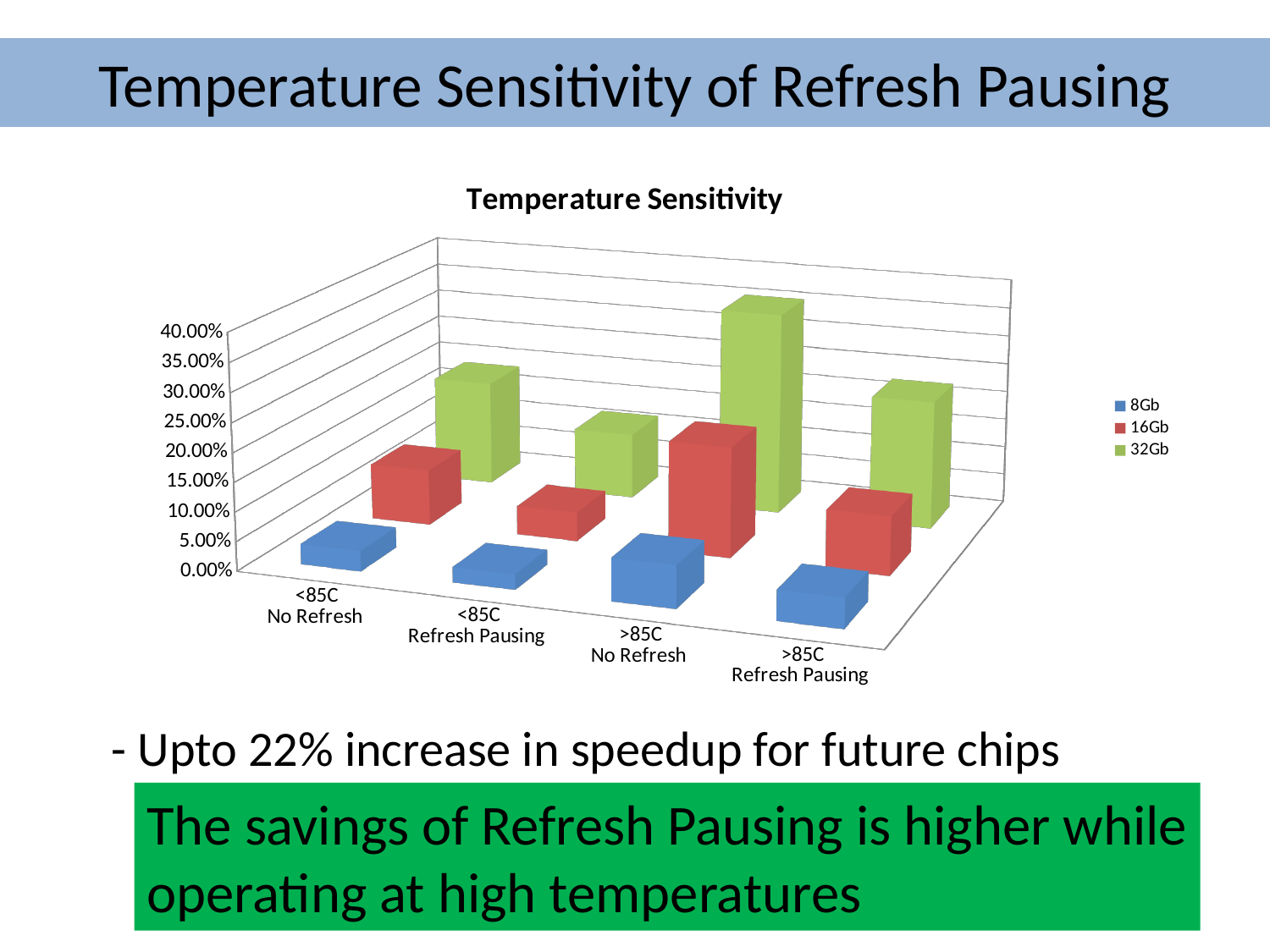
What is the title of the chart? Temperature Sensitivity For the "<85C No Refresh" category, which is larger: the 32Gb value or the 8Gb value? 32Gb Which series are listed in the legend? 8Gb, 16Gb, 32Gb For the 16Gb series, which is larger: the value for ">85C No Refresh" or the value for "<85C Refresh Pausing"? >85C No Refresh How many series does the legend list? 3 How many categories are shown on the x axis? 4 Which series has the lowest value for the ">85C Refresh Pausing" category? 8Gb Is the 32Gb value for ">85C No Refresh" greater or less than 20.00%? greater Is the 8Gb value for "<85C No Refresh" greater or less than 10.00%? less For which category is the 32Gb bar the tallest? >85C No Refresh What kind of chart is shown on the slide? Bar chart Which series has the highest value for the ">85C No Refresh" category? 32Gb